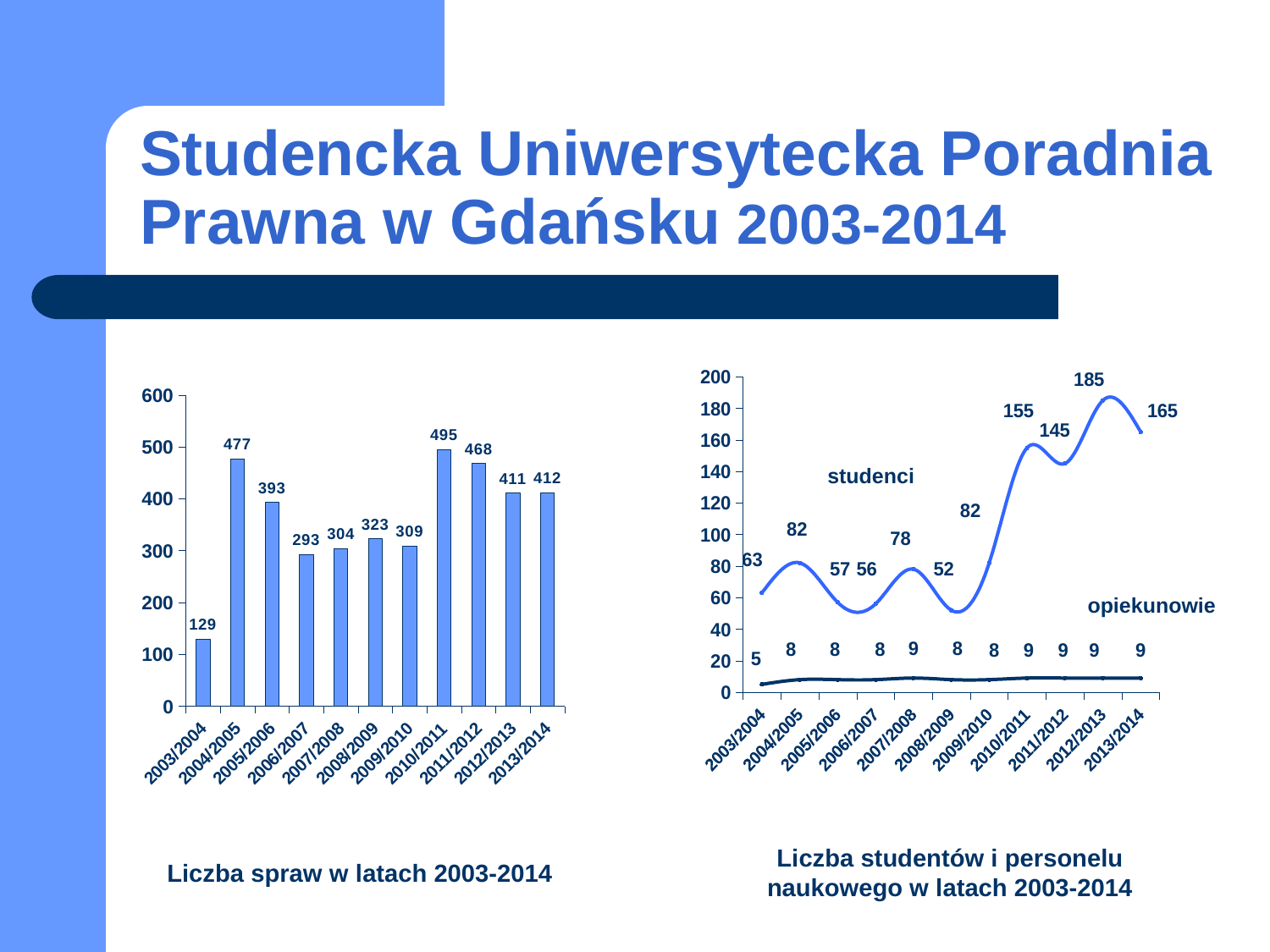
In the chart 'Liczba spraw w latach 2003-2014', which year has the highest value? 2010/2011 What kind of chart is 'Liczba spraw w latach 2003-2014'? bar chart In the chart 'Liczba studentów i personelu naukowego w latach 2003-2014', what is the value for opiekunowie in 2003/2004? 5 In the chart 'Liczba spraw w latach 2003-2014', which year has the lowest value? 2003/2004 In the chart 'Liczba spraw w latach 2003-2014', what is the difference between the values for 2010/2011 and 2011/2012? 27 In the chart 'Liczba spraw w latach 2003-2014', what is the value for 2004/2005? 477 In the chart 'Liczba spraw w latach 2003-2014', how many years are shown on the x axis? 11 In the chart 'Liczba studentów i personelu naukowego w latach 2003-2014', what is the value for studenci in 2012/2013? 185 In the chart 'Liczba studentów i personelu naukowego w latach 2003-2014', which year has the lowest value for studenci? 2008/2009 What kind of chart is 'Liczba studentów i personelu naukowego w latach 2003-2014'? line chart In the chart 'Liczba studentów i personelu naukowego w latach 2003-2014', what is the difference between studenci and opiekunowie in 2013/2014? 156 In the chart 'Liczba studentów i personelu naukowego w latach 2003-2014', is the value for studenci in 2010/2011 larger than in 2011/2012? Yes